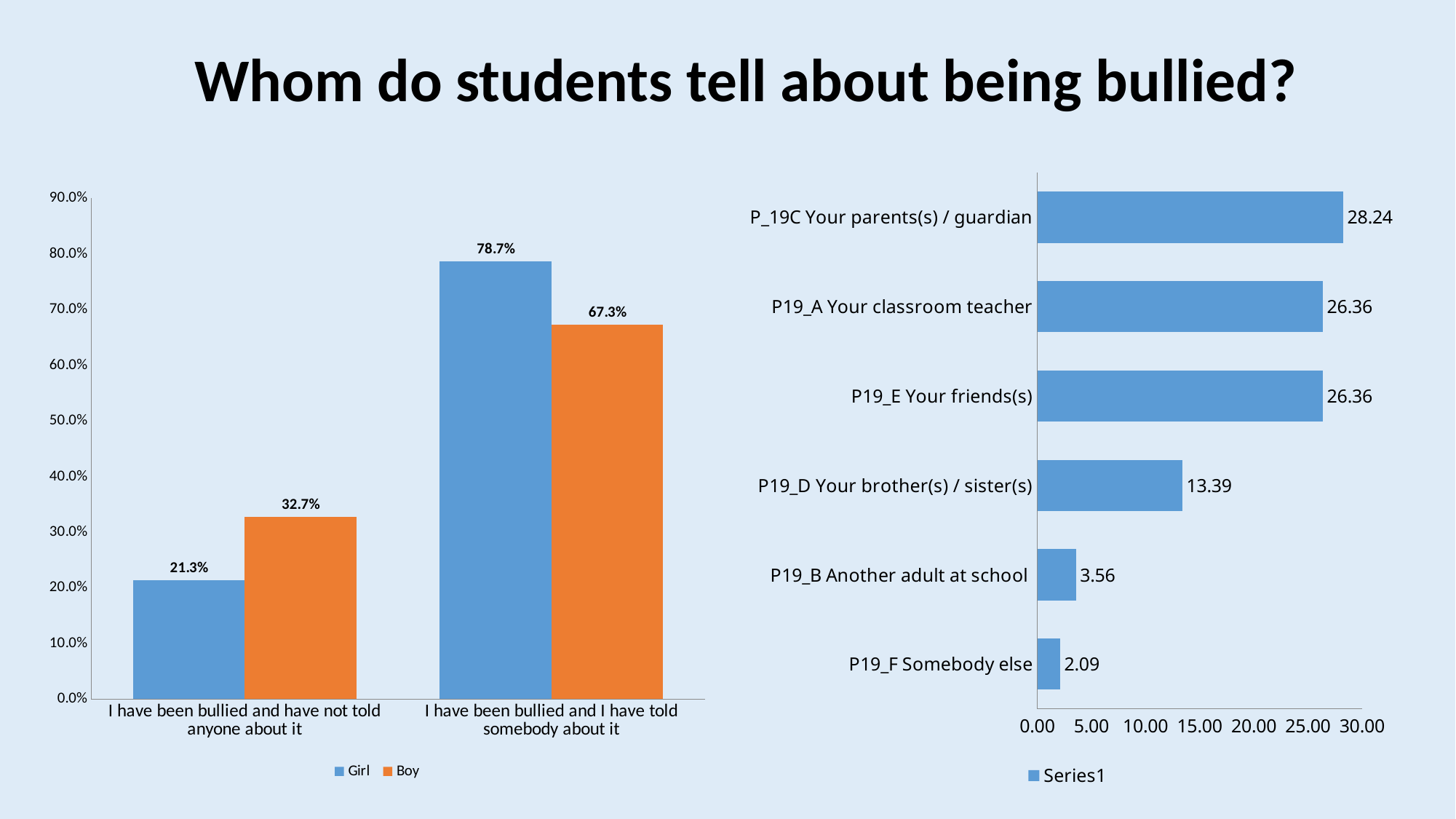
In the left chart, what is the value for Boy in the category 'I have been bullied and I have told somebody about it'? 67.3% In the right chart, what is the difference between the values for 'P19_A Your classroom teacher' and 'P19_B Another adult at school'? 22.80 In the right chart, which category has the highest value? P_19C Your parents(s) / guardian What kind of chart is the left chart? Bar chart In the left chart, which series has the larger value for 'I have been bullied and have not told anyone about it', Girl or Boy? Boy In the left chart, what is the value for Girl in the category 'I have been bullied and have not told anyone about it'? 21.3% In the left chart, what is the difference between the Girl and Boy values for 'I have been bullied and I have told somebody about it'? 11.4% In the right chart, which category has the lowest value? P19_F Somebody else In the right chart, what is the value for 'P_19C Your parents(s) / guardian'? 28.24 How many series does the legend of the left chart list? 2 In the right chart, what is the value for 'P19_D Your brother(s) / sister(s)'? 13.39 How many categories are shown in the right chart? 6